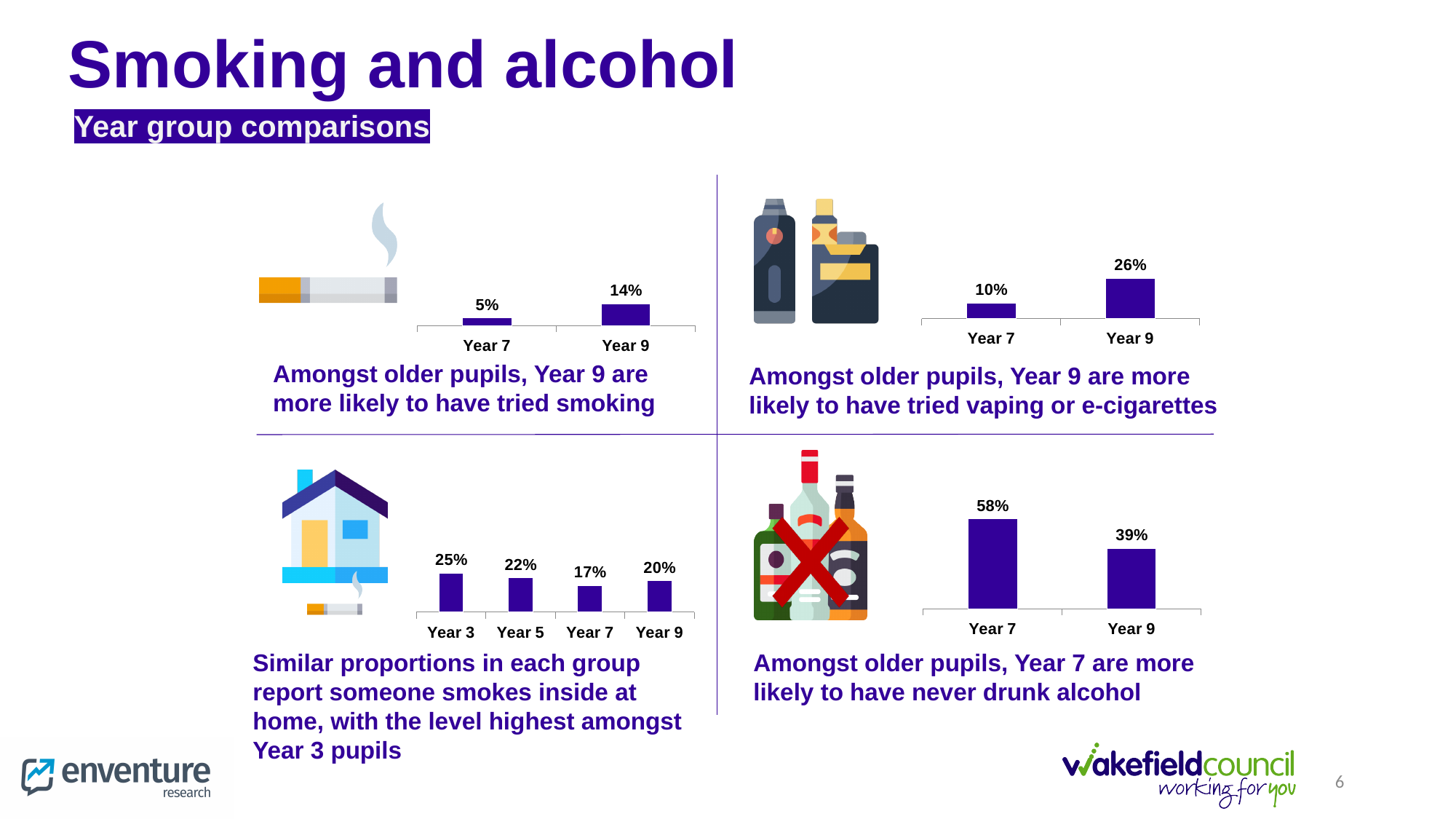
What type of chart is the top-left chart (tried smoking)? Bar chart How many year groups are shown in the bottom-left chart (someone smokes inside at home)? 4 In the bottom-right chart (never drunk alcohol), what is the value for Year 7? 58% In the bottom-right chart (never drunk alcohol), which is larger, Year 7 or Year 9? Year 7 In the top-left chart (tried smoking), what is the value for Year 9? 14% In the top-left chart (tried smoking), what is the value for Year 7? 5% In the bottom-left chart (someone smokes inside at home), what is the value for Year 5? 22% In the bottom-right chart (never drunk alcohol), what is the difference between Year 7 and Year 9? 19 percentage points In the bottom-left chart (someone smokes inside at home), which year group has the highest value? Year 3 In the top-right chart (tried vaping or e-cigarettes), what is the difference between Year 9 and Year 7? 16 percentage points In the top-right chart (tried vaping or e-cigarettes), what is the value for Year 9? 26% In the bottom-left chart (someone smokes inside at home), which year group has the lowest value? Year 7